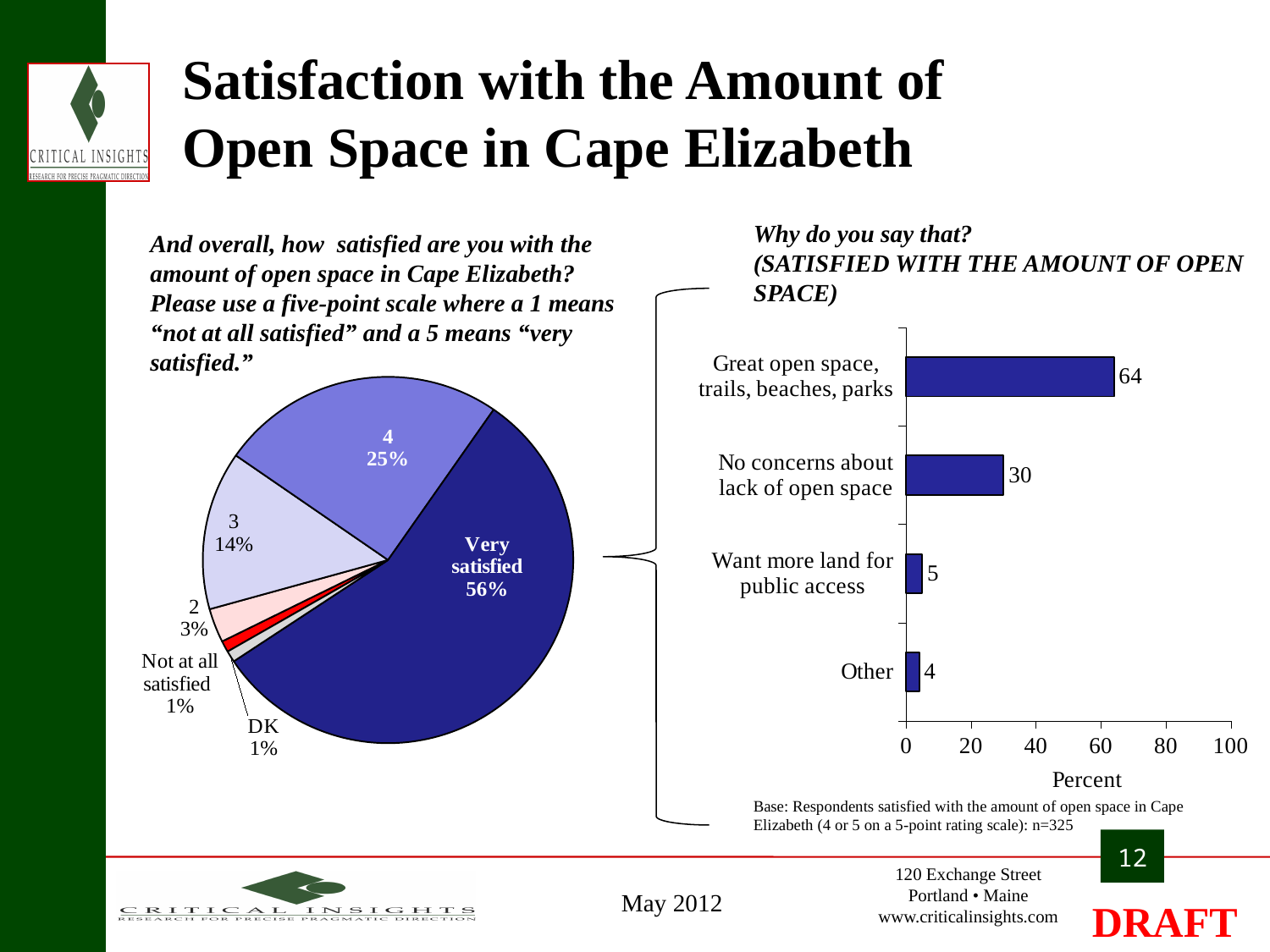
What type of chart is on the right side of the slide? Bar chart In the pie chart on the left, what share of respondents are "Very satisfied"? 56% In the bar chart on the right, what is the difference between "Great open space, trails, beaches, parks" and "No concerns about lack of open space"? 34 In the pie chart on the left, what share of respondents gave a rating of 3? 14% In the bar chart on the right, what is the value for "No concerns about lack of open space"? 30 In the pie chart on the left, how many slices are there? 6 In the bar chart on the right, which category has the lowest value? Other In the pie chart on the left, what is the difference between the "Very satisfied" share and the share rating 4? 31% In the pie chart on the left, what share of respondents gave a rating of 4? 25% In the pie chart on the left, which slice is the largest? Very satisfied In the bar chart on the right, how many categories are shown? 4 In the bar chart on the right, what is the value for "Great open space, trails, beaches, parks"? 64